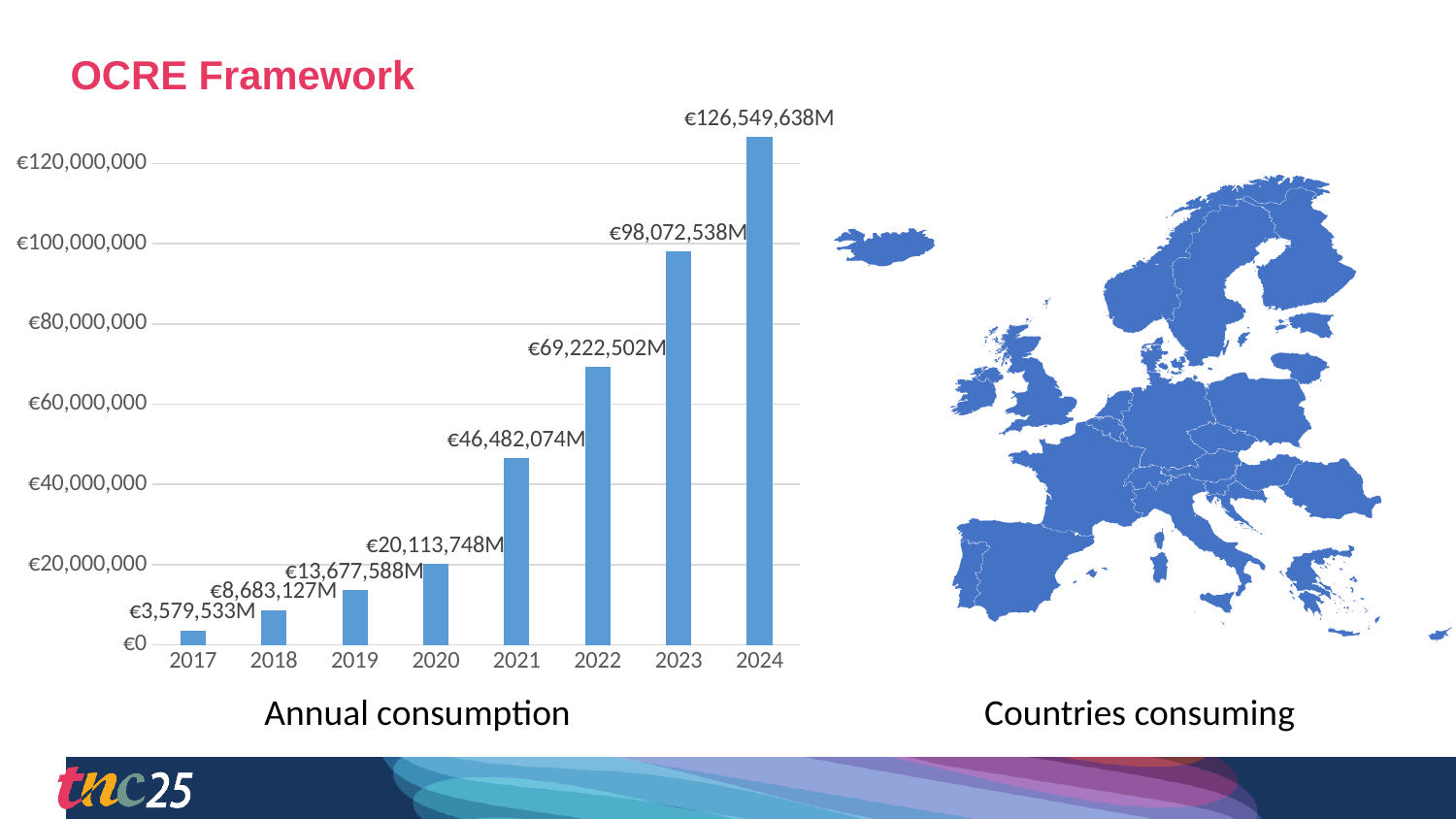
What is the annual consumption value for 2017? €3,579,533M Does annual consumption rise or fall from 2017 to 2024? rise What is the annual consumption value for 2024? €126,549,638M How many years are shown on the annual consumption chart? 8 What is the difference between the annual consumption in 2022 and 2021? €22,740,428M Which year has the lowest annual consumption? 2017 Which year has a larger annual consumption, 2020 or 2022? 2022 What is the annual consumption value for 2021? €46,482,074M Is the annual consumption for 2023 greater or less than €80,000,000? greater Which year has the highest annual consumption? 2024 What kind of chart is used to show annual consumption? bar chart What is the difference between the annual consumption in 2024 and 2023? €28,477,100M